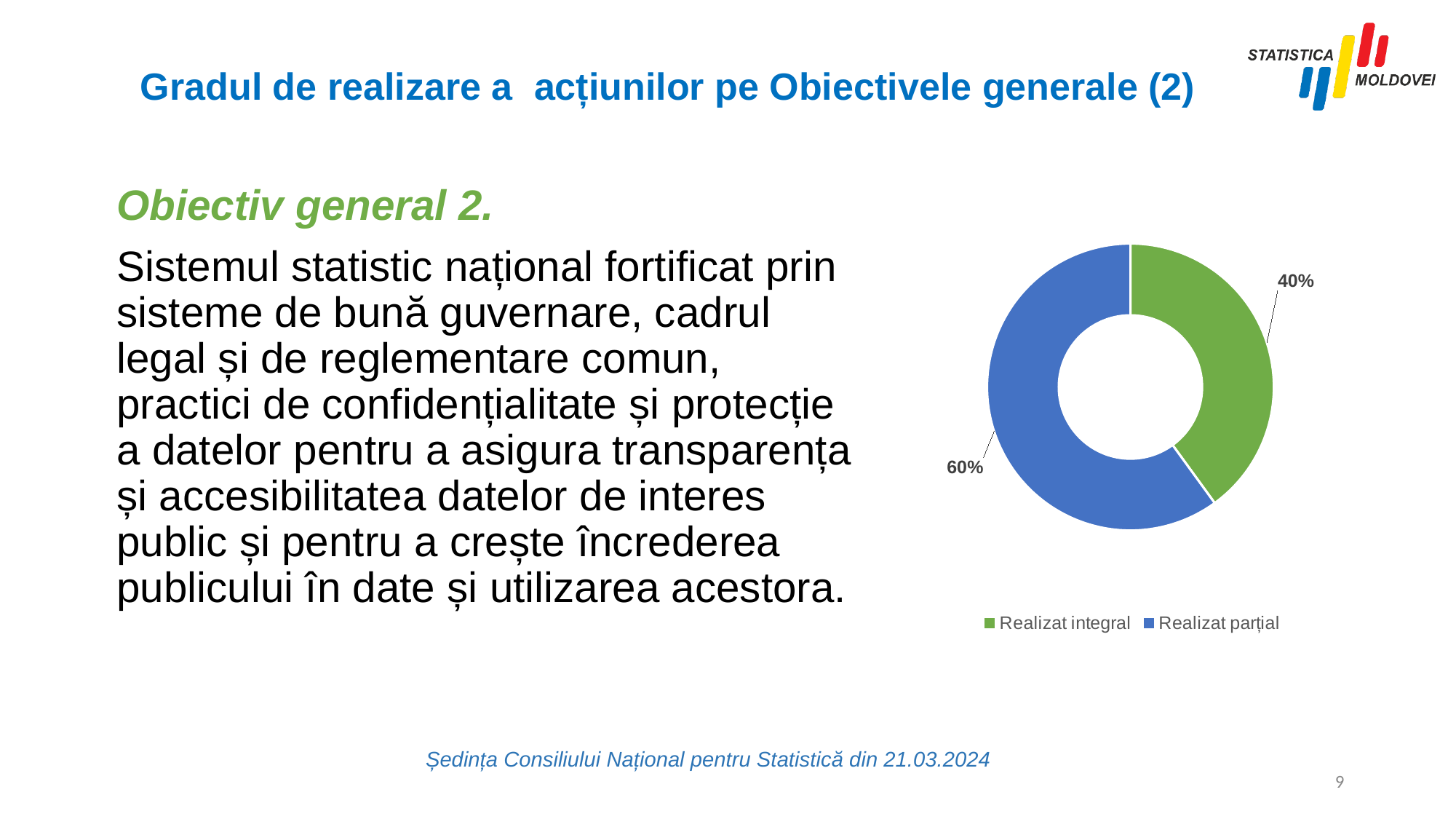
Which is larger: the share for "Realizat integral" or the share for "Realizat parțial"? Realizat parțial What colour represents "Realizat parțial" in the chart? Blue How many categories does the chart show? 2 How many entries does the chart legend list? 2 What colour represents "Realizat integral" in the chart? Green Which category has the largest share in the chart? Realizat parțial Which category has the smallest share in the chart? Realizat integral What kind of chart is shown on the slide? Doughnut (pie) chart What share of the chart is labelled "Realizat integral"? 40% What is the difference in percentage points between "Realizat parțial" and "Realizat integral"? 20 What share of the chart is labelled "Realizat parțial"? 60%